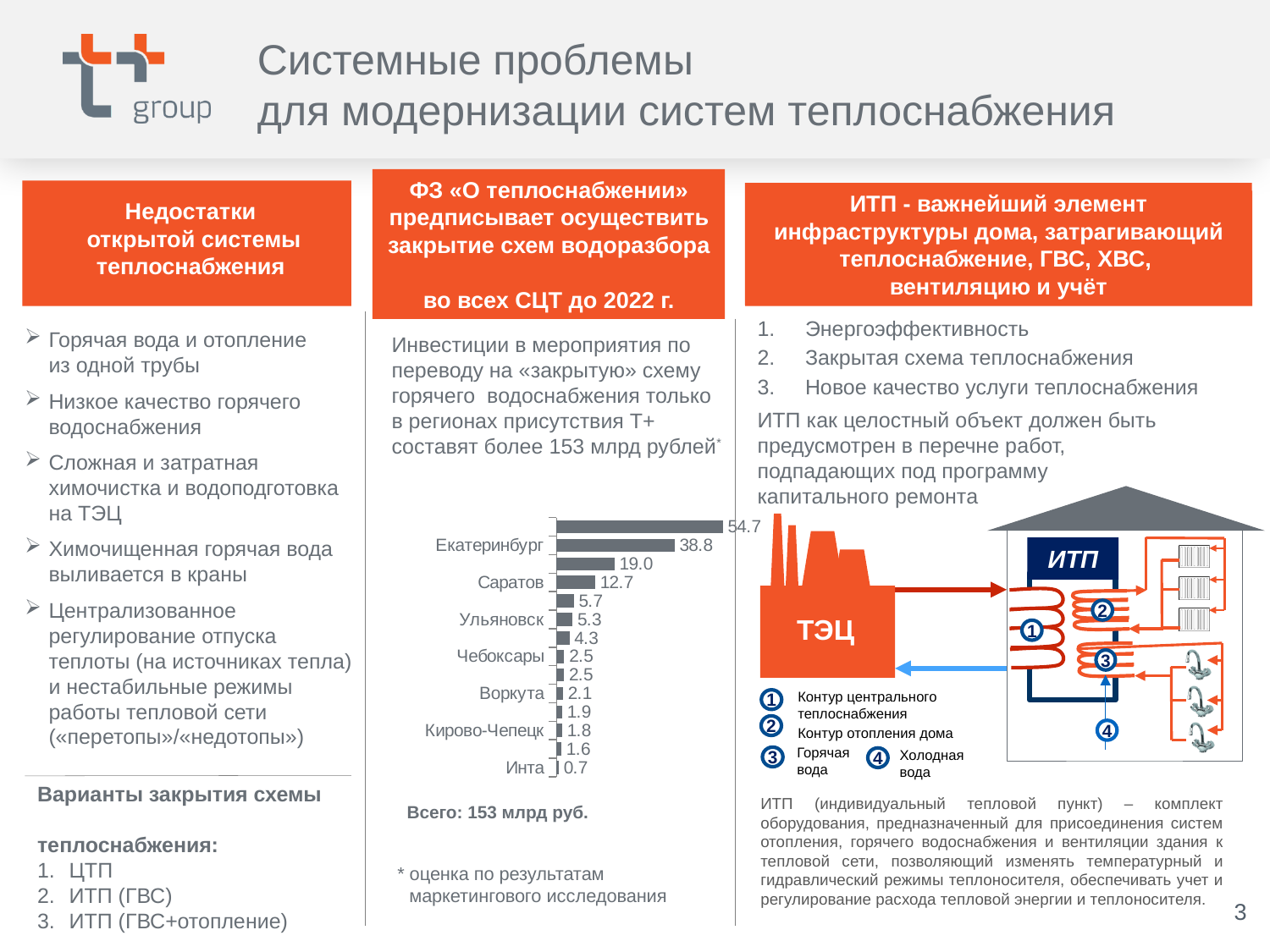
What is the value for Саратов in the bar chart? 12.7 What is the difference between the values for Екатеринбург and Саратов? 26.1 What is the value for Кирово-Чепецк in the bar chart? 1.8 Which is larger, the value for Саратов or the value for Воркута? Саратов What is the value for Екатеринбург in the bar chart? 38.8 What is the largest data label value shown in the bar chart? 54.7 What is the value for Чебоксары in the bar chart? 2.5 What is the value for Ульяновск in the bar chart? 5.3 What total is stated below the bar chart? 153 млрд руб. What kind of chart is shown on the slide? bar chart Which labeled category has the lowest value in the bar chart? Инта How many bars are plotted in the bar chart? 14